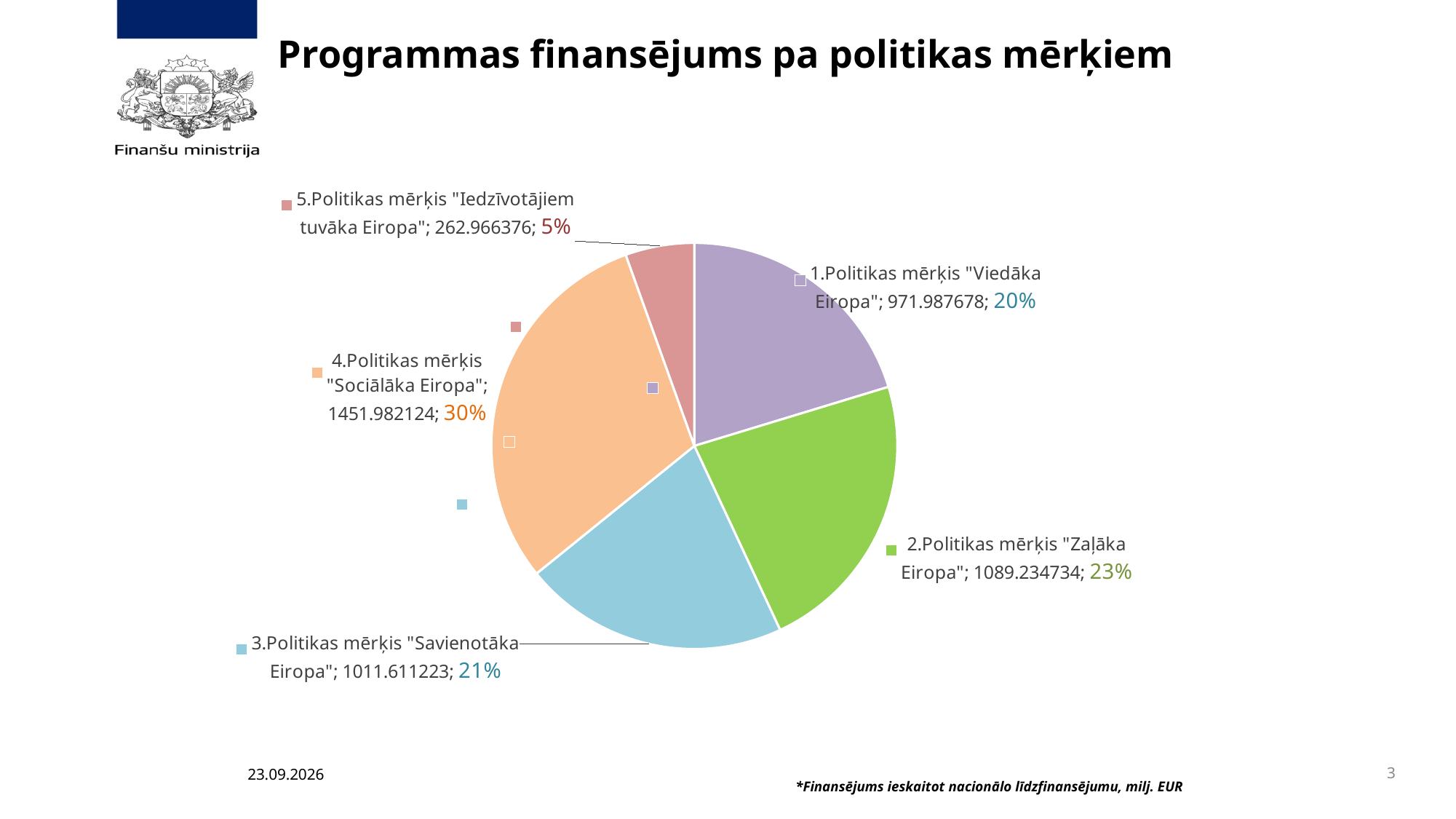
What is the difference in percentage share between 4.Politikas mērķis "Sociālāka Eiropa" and 5.Politikas mērķis "Iedzīvotājiem tuvāka Eiropa"? 25% Which is larger: the value for 2.Politikas mērķis "Zaļāka Eiropa" or 3.Politikas mērķis "Savienotāka Eiropa"? 2.Politikas mērķis "Zaļāka Eiropa" What type of chart is shown on the slide? pie chart How many slices does the pie chart have? 5 What is the difference between the values for 2.Politikas mērķis "Zaļāka Eiropa" and 1.Politikas mērķis "Viedāka Eiropa"? 117.247056 Which policy objective has the largest share of the pie? 4.Politikas mērķis "Sociālāka Eiropa" Which policy objective has the smallest share of the pie? 5.Politikas mērķis "Iedzīvotājiem tuvāka Eiropa" What percentage share does 2.Politikas mērķis "Zaļāka Eiropa" have? 23% What is the value for 5.Politikas mērķis "Iedzīvotājiem tuvāka Eiropa"? 262.966376 What percentage share does 1.Politikas mērķis "Viedāka Eiropa" have? 20% What is the title of the chart on the slide? Programmas finansējums pa politikas mērķiem What is the value for 4.Politikas mērķis "Sociālāka Eiropa"? 1451.982124